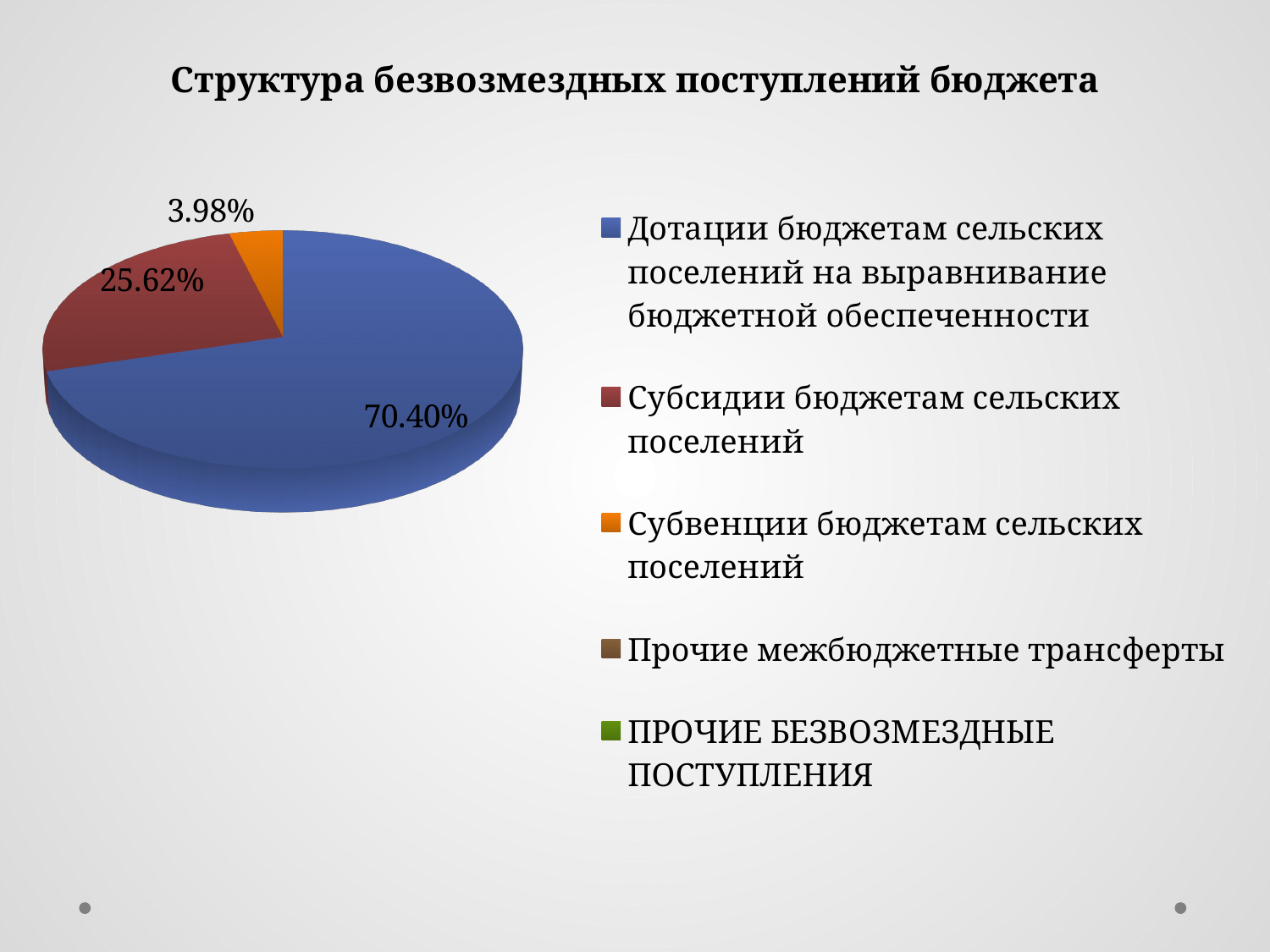
What share of the pie is labelled for "Субсидии бюджетам сельских поселений"? 25.62% How many slices have a percentage label printed on the chart? 3 What colour is the slice for "Субвенции бюджетам сельских поселений"? Orange What share of the pie is labelled for "Дотации бюджетам сельских поселений на выравнивание бюджетной обеспеченности"? 70.40% What is the difference between the shares for "Дотации бюджетам сельских поселений на выравнивание бюджетной обеспеченности" and "Субсидии бюджетам сельских поселений"? 44.78% Which category has the largest slice of the pie? Дотации бюджетам сельских поселений на выравнивание бюджетной обеспеченности What is the title of the chart? Структура безвозмездных поступлений бюджета How many entries does the legend list? 5 Which of the labelled slices is the smallest? Субвенции бюджетам сельских поселений What kind of chart is shown on the slide? Pie chart Which is larger: the share for "Субсидии бюджетам сельских поселений" or for "Субвенции бюджетам сельских поселений"? Субсидии бюджетам сельских поселений What share of the pie is labelled for "Субвенции бюджетам сельских поселений"? 3.98%